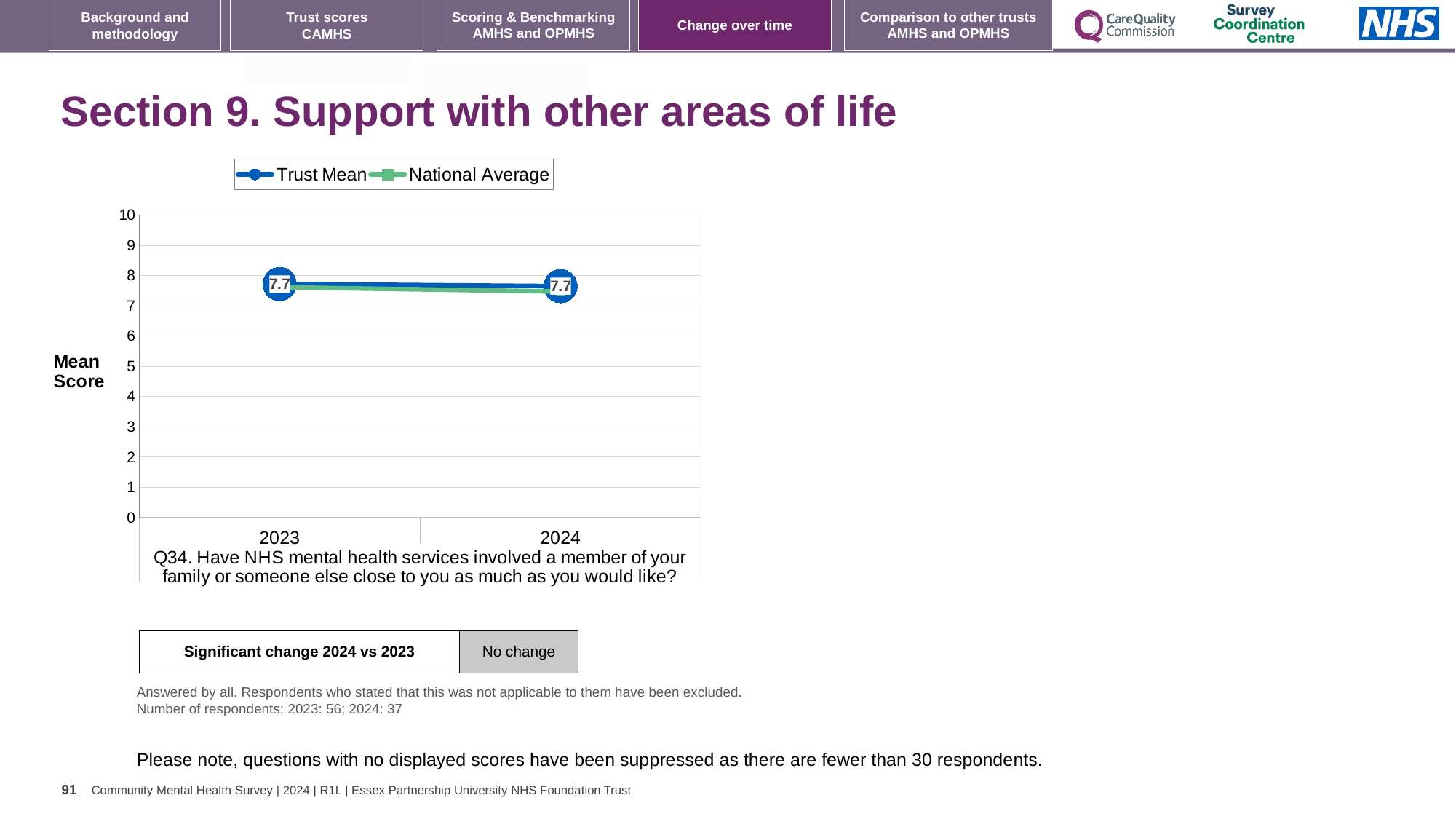
What is the Trust Mean score for 2024? 7.7 Is the National Average value for 2023 greater or less than 9? less How many series does the legend list? 2 What is the Trust Mean score for 2023? 7.7 What are the two series named in the legend? Trust Mean and National Average What is the difference between the Trust Mean score in 2024 and in 2023? 0 Does the Trust Mean rise, fall or stay the same from 2023 to 2024? Stays the same Is the National Average value for 2024 greater or less than 5? greater How many years are plotted on the x axis? 2 What is the label on the y axis of the chart? Mean Score What kind of chart is shown on the slide? Line chart